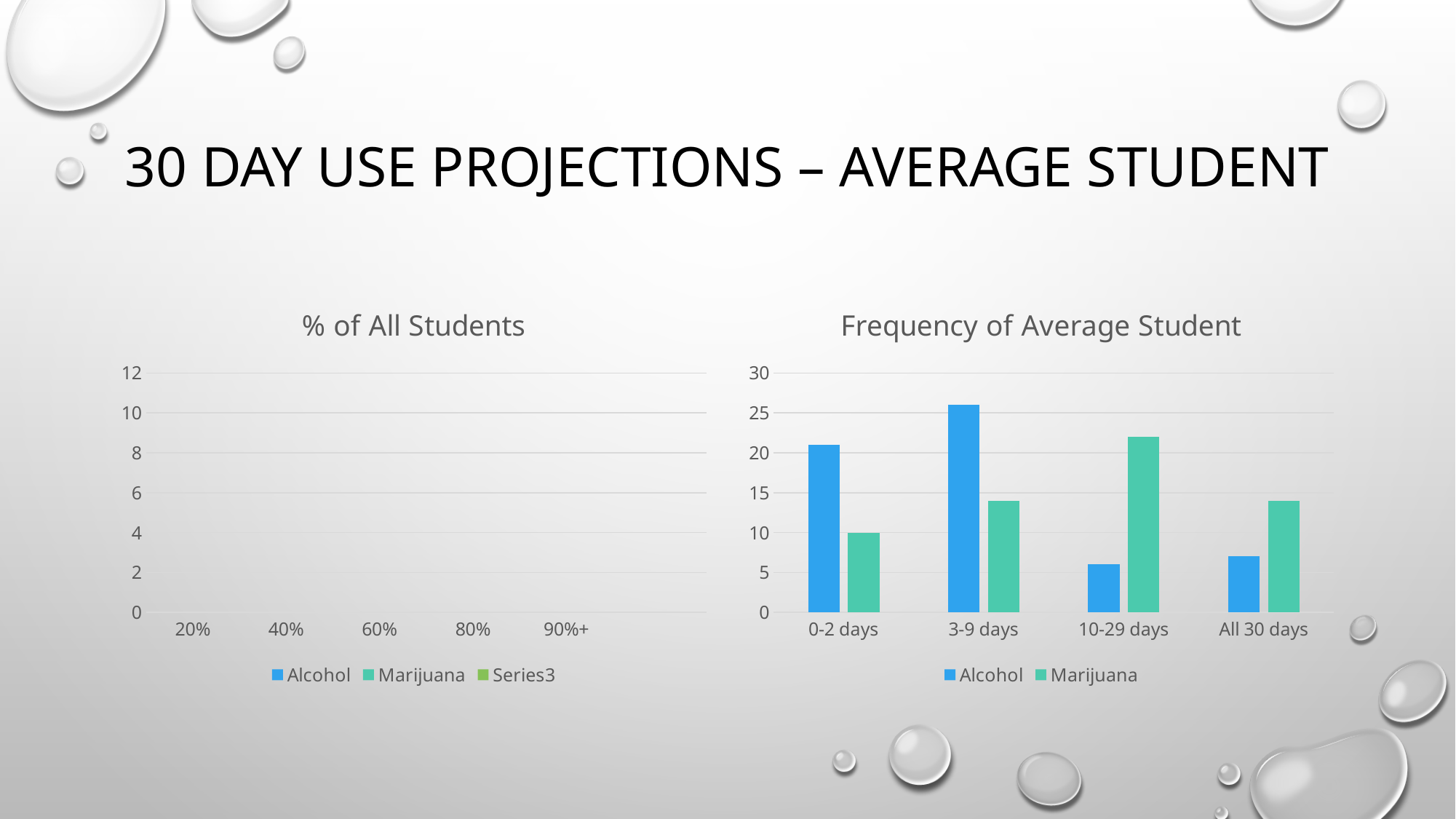
In the 'Frequency of Average Student' chart, for 10-29 days, which is larger: Alcohol or Marijuana? Marijuana In the 'Frequency of Average Student' chart, how many categories are shown on the x axis? 4 In the 'Frequency of Average Student' chart, is the Alcohol value for All 30 days greater or less than 10? less In the 'Frequency of Average Student' chart, which category has the highest Alcohol value? 3-9 days In the 'Frequency of Average Student' chart, how many series does the legend list? 2 In the 'Frequency of Average Student' chart, which category has the highest Marijuana value? 10-29 days In the 'Frequency of Average Student' chart, which category has the lowest Marijuana value? 0-2 days In the 'Frequency of Average Student' chart, for 0-2 days, which is larger: Alcohol or Marijuana? Alcohol In the 'Frequency of Average Student' chart, which category has the lowest Alcohol value? 10-29 days In the 'Frequency of Average Student' chart, is the Alcohol value for 3-9 days greater or less than 25? greater In the 'Frequency of Average Student' chart, what kind of chart is shown? bar chart How many series does the legend of the '% of All Students' chart list? 3